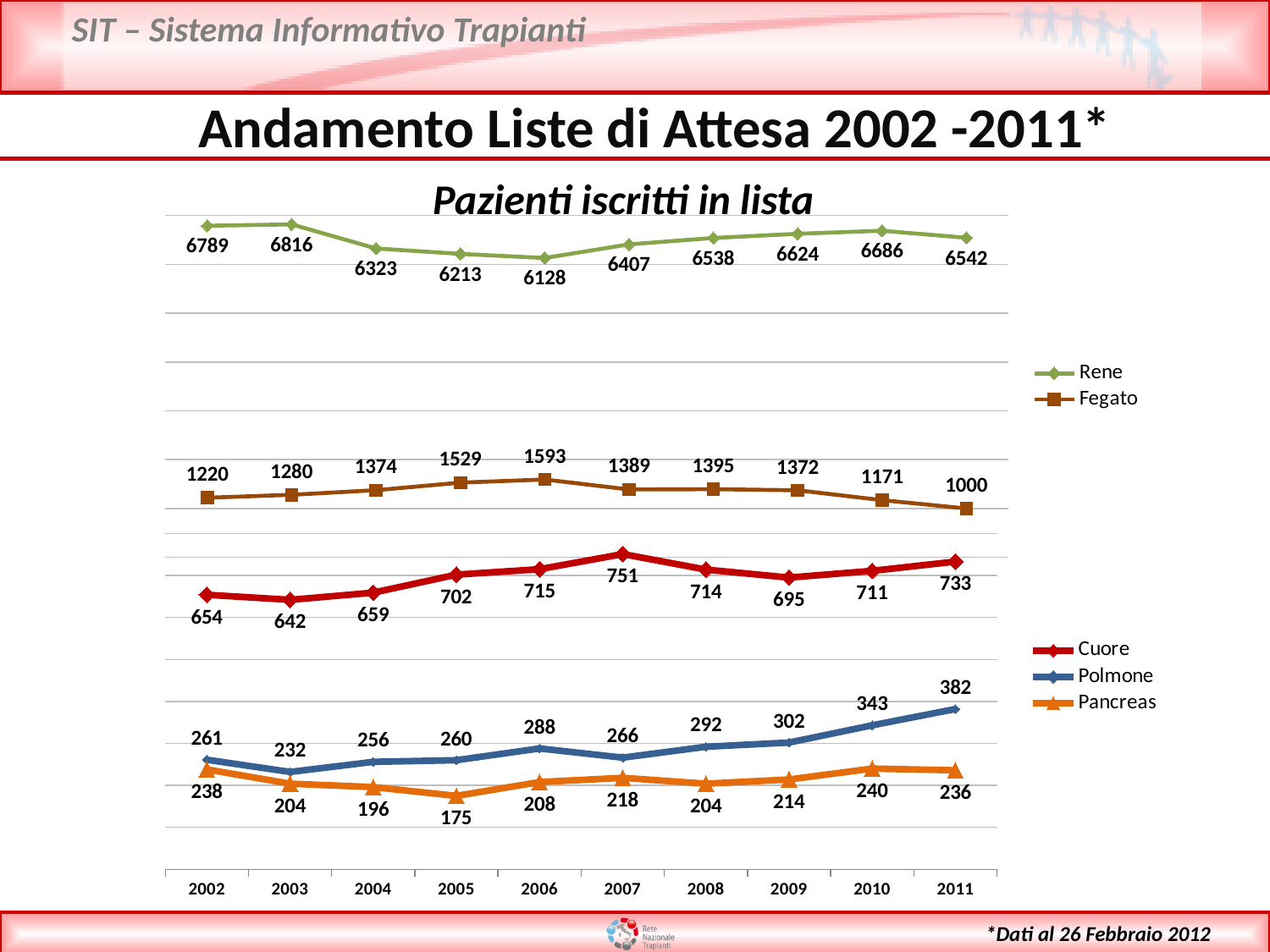
What is the difference between the Polmone values in 2011 and 2002? 121 What is the value for Rene in 2006? 6128 How many series does the legend list? 5 Which is larger, the Cuore value in 2011 or the Cuore value in 2002? 2011 What is the value for Fegato in 2011? 1000 What kind of chart is shown on the slide? line chart What is the value for Pancreas in 2005? 175 In which year does the Polmone series reach its highest value? 2011 In which year does the Fegato series reach its highest value? 2006 How many years are shown on the x axis? 10 What is the value for Cuore in 2007? 751 In which year is the Rene series at its lowest? 2006